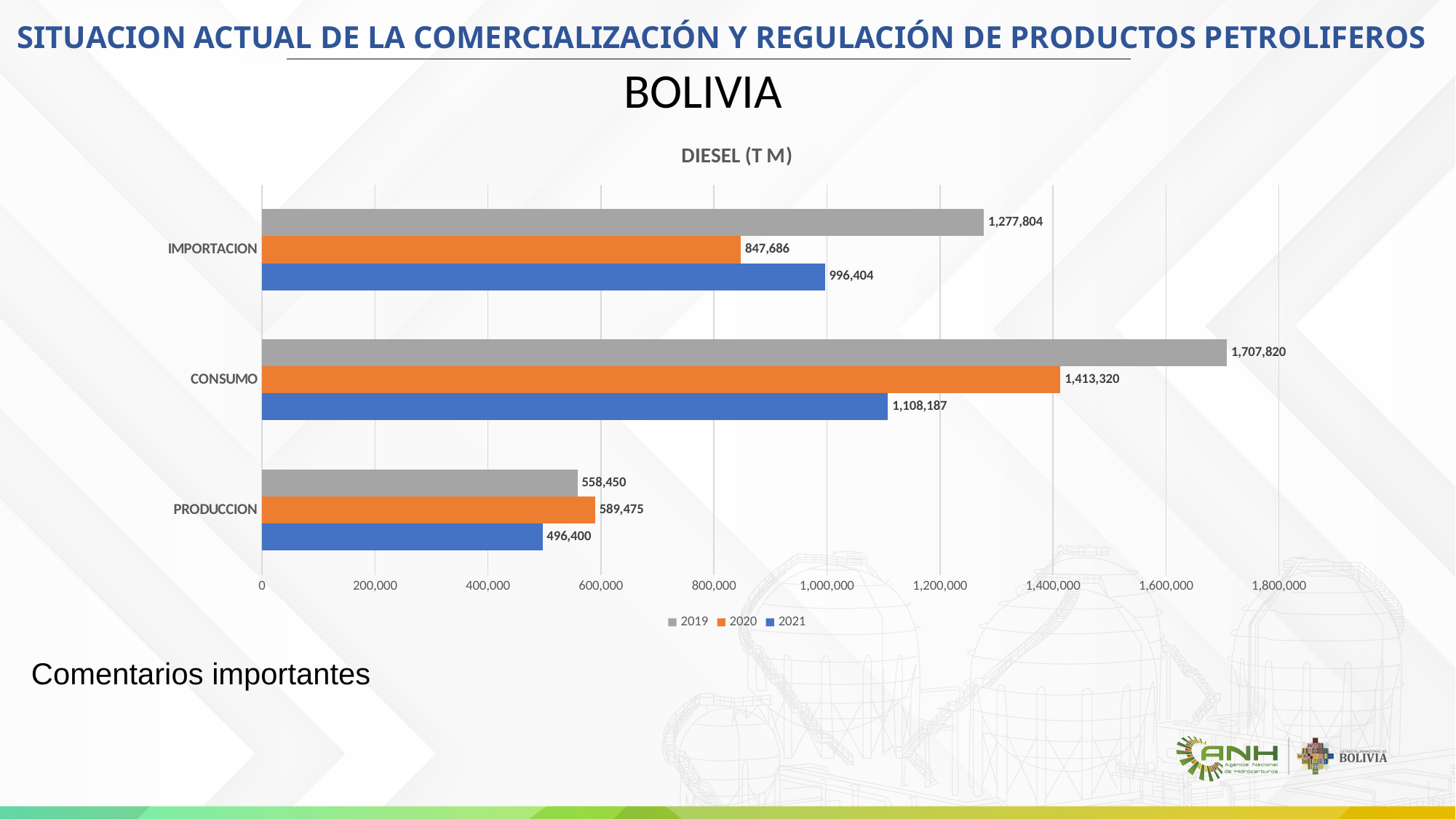
What is the value for IMPORTACION in 2019? 1,277,804 What is the title of the chart? DIESEL (T M) How many series does the legend list? 3 Is the value for PRODUCCION in 2019 greater or less than 600,000? less What is the value for PRODUCCION in 2020? 589,475 What is the difference between the 2019 and 2020 values for CONSUMO? 294,500 Which category has the lowest value in 2021? PRODUCCION How many categories are shown on the chart? 3 Which is larger for IMPORTACION, the 2020 value or the 2021 value? 2021 Which category has the highest value in 2019? CONSUMO What is the value for CONSUMO in 2021? 1,108,187 What type of chart is shown on the slide? bar chart